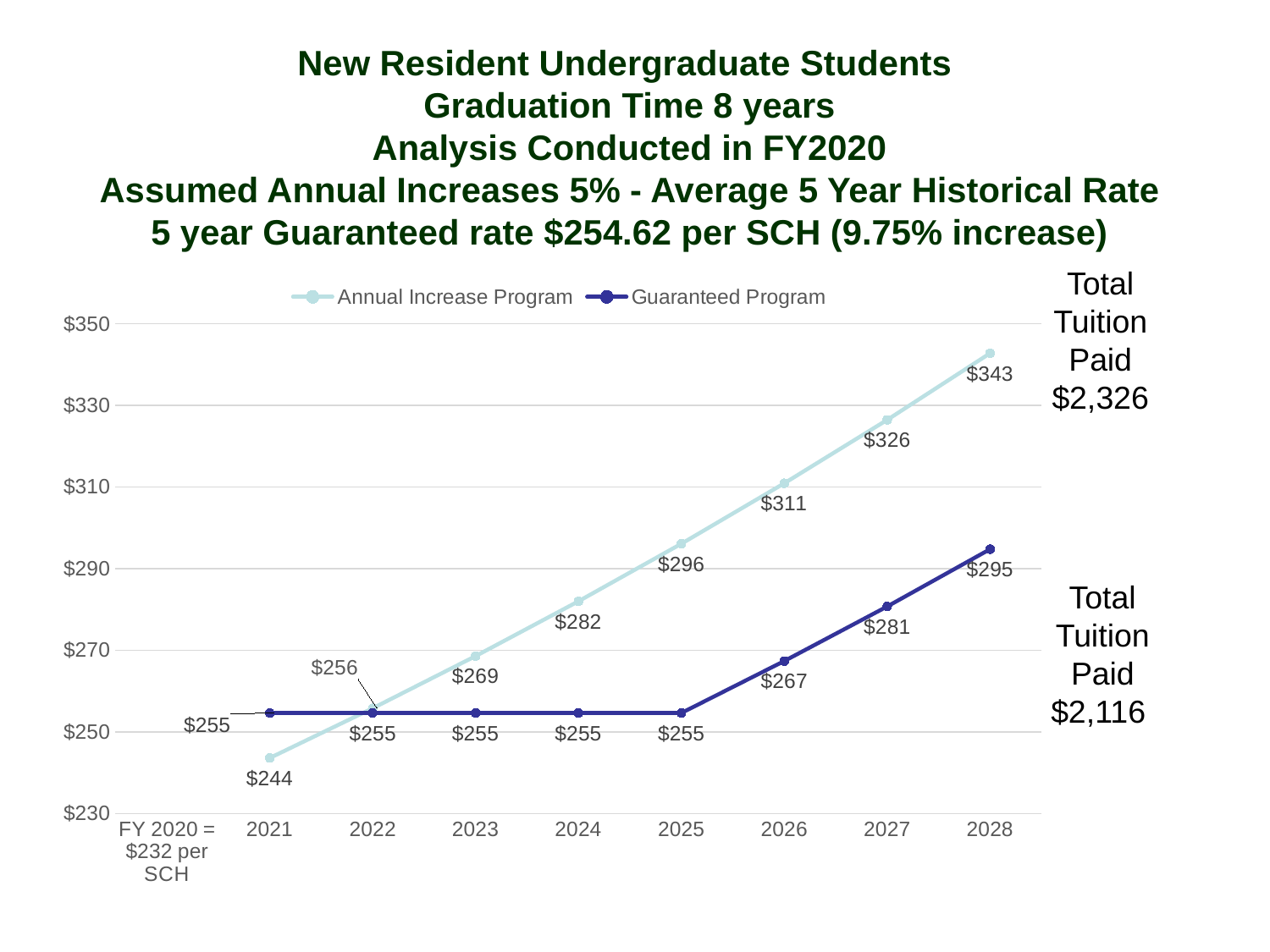
In which year is the Guaranteed Program value highest? 2028 How many years are plotted along the x axis? 8 In which year is the Annual Increase Program value lowest? 2021 What is the value for the Annual Increase Program in 2021? $244 What is the Total Tuition Paid shown for the Guaranteed Program? $2,116 Which series has the larger value in 2027, Annual Increase Program or Guaranteed Program? Annual Increase Program What is the value for the Guaranteed Program in 2026? $267 What type of chart is shown on the slide? line chart Do the Annual Increase Program values rise or fall from 2021 to 2028? rise What is the value for the Annual Increase Program in 2028? $343 What is the difference between the Annual Increase Program and the Guaranteed Program values in 2028? $48 How many series does the legend list? 2